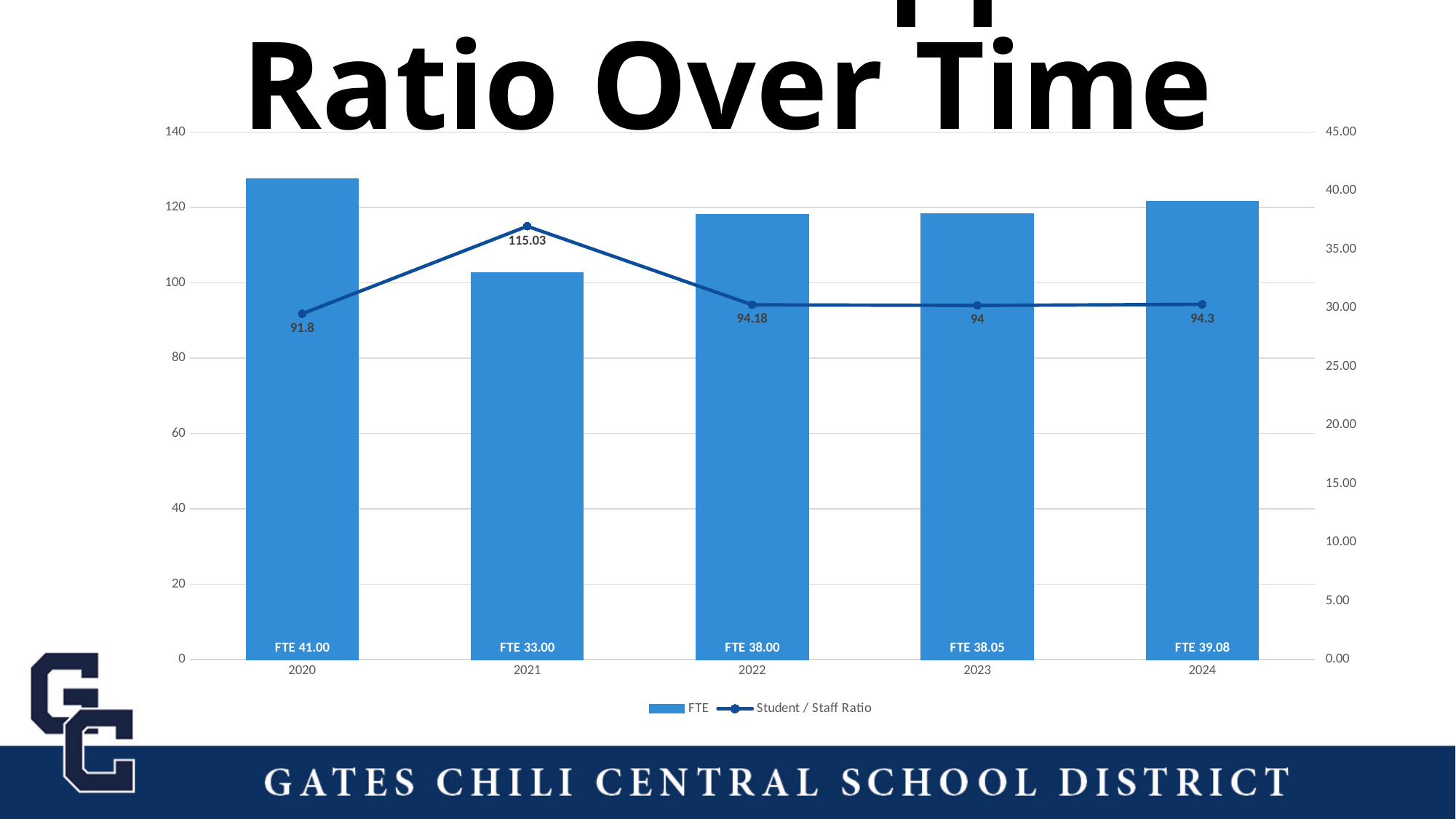
Which year has the lowest FTE? 2021 How many years are shown on the x axis? 5 What is the Student / Staff Ratio value for 2021? 115.03 How many series does the legend list? 2 What is the difference between the Student / Staff Ratio in 2021 and in 2020? 23.23 What is the Student / Staff Ratio value for 2023? 94 What is the FTE value for 2024? FTE 39.08 What kind of chart is shown on the slide? Combined bar and line chart What is the difference between the FTE in 2020 and the FTE in 2021? 8.00 What is the FTE value for 2020? FTE 41.00 Which year has a larger FTE, 2022 or 2024? 2024 Which year has the highest Student / Staff Ratio? 2021